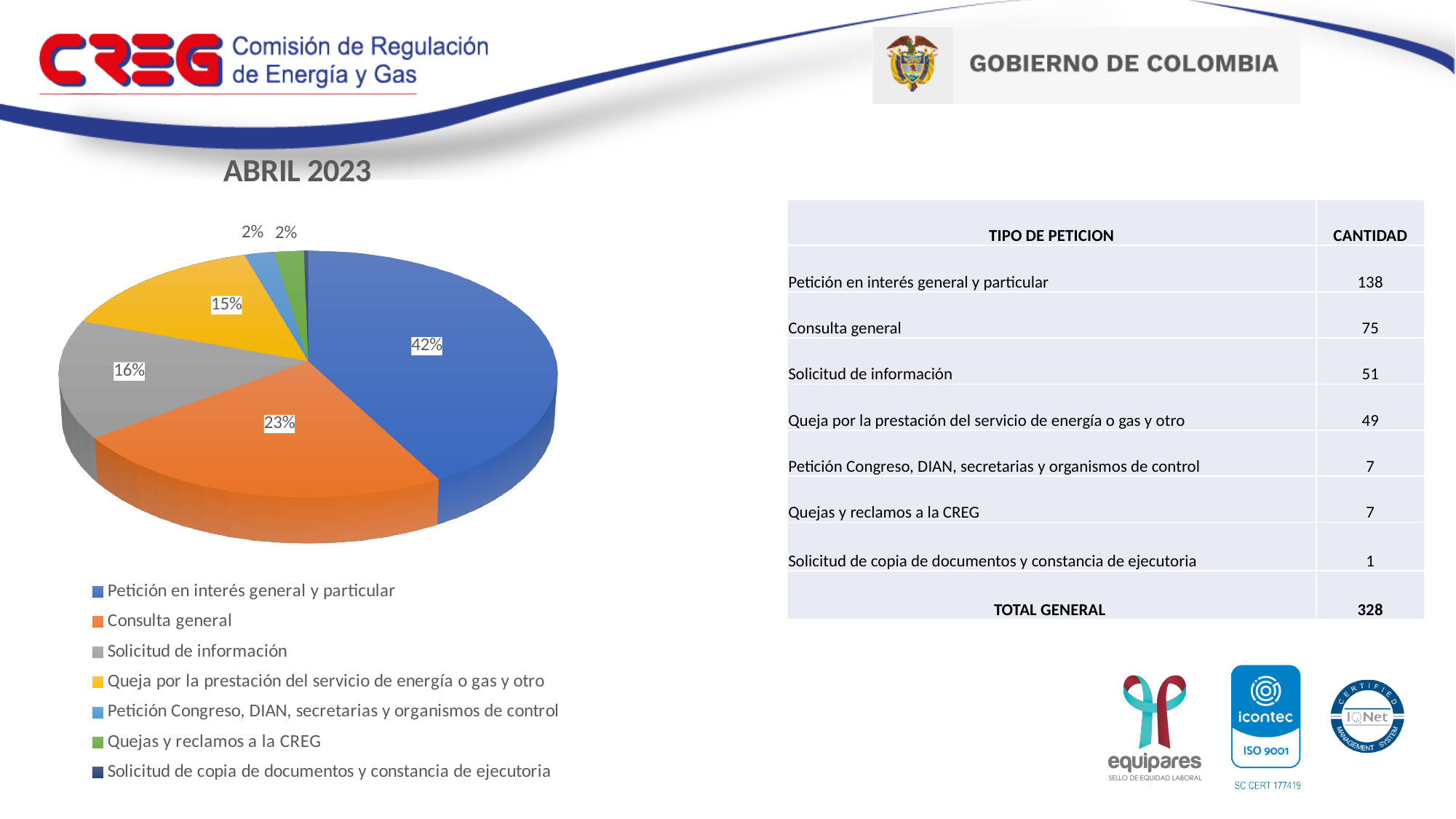
What type of chart is shown on the slide? pie chart What percentage of the pie does 'Solicitud de información' represent? 16% What percentage of the pie does 'Queja por la prestación del servicio de energía o gas y otro' represent? 15% Which is larger in the pie chart: 'Consulta general' or 'Solicitud de información'? Consulta general How many categories does the pie chart's legend list? 7 What percentage of the pie does 'Consulta general' represent? 23% What is the title shown above the pie chart? ABRIL 2023 What percentage of the pie does 'Quejas y reclamos a la CREG' represent? 2% What percentage of the pie does 'Petición en interés general y particular' represent? 42% What colour is the 'Consulta general' slice in the pie chart? orange Which category has the largest slice of the pie? Petición en interés general y particular What is the difference in percentage points between the 'Petición en interés general y particular' slice and the 'Consulta general' slice? 19